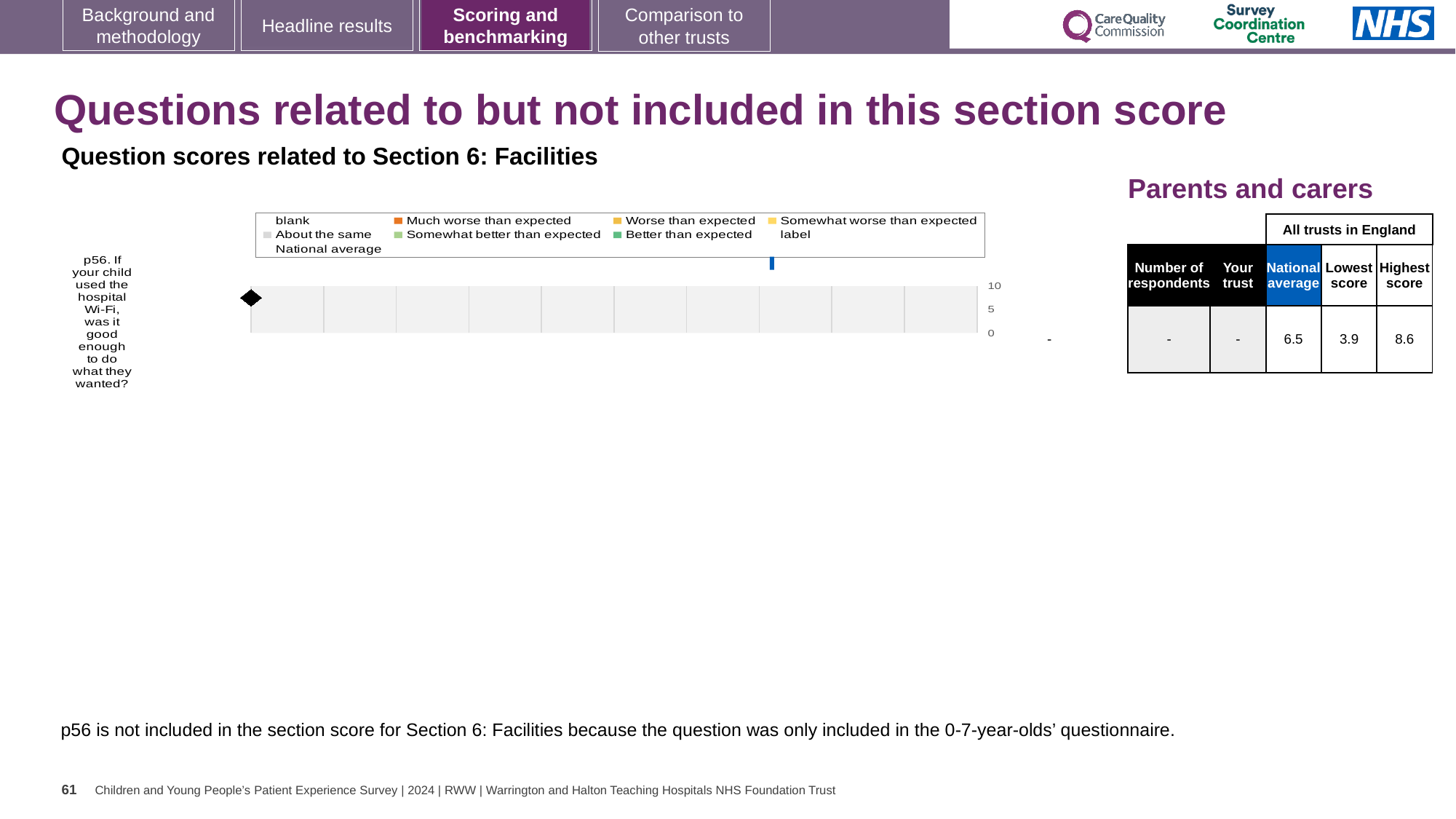
What is the highest value shown on the chart's vertical axis? 10 In the 'Parents and carers' table, what is the National average score for p56? 6.5 In the 'Parents and carers' table, what is the Highest score for p56? 8.6 In the 'Parents and carers' table, what is shown for 'Your trust' for p56? - In the 'Parents and carers' table, is the National average for p56 greater or less than 5? greater In the 'Parents and carers' table, what is the difference between the Highest score and the Lowest score for p56? 4.7 In the 'Parents and carers' table, what is the Lowest score for p56? 3.9 Which question is plotted on the chart? p56. If your child used the hospital Wi-Fi, was it good enough to do what they wanted? How many question categories are plotted on the chart? 1 What kind of chart is shown under 'Question scores related to Section 6: Facilities'? bar chart